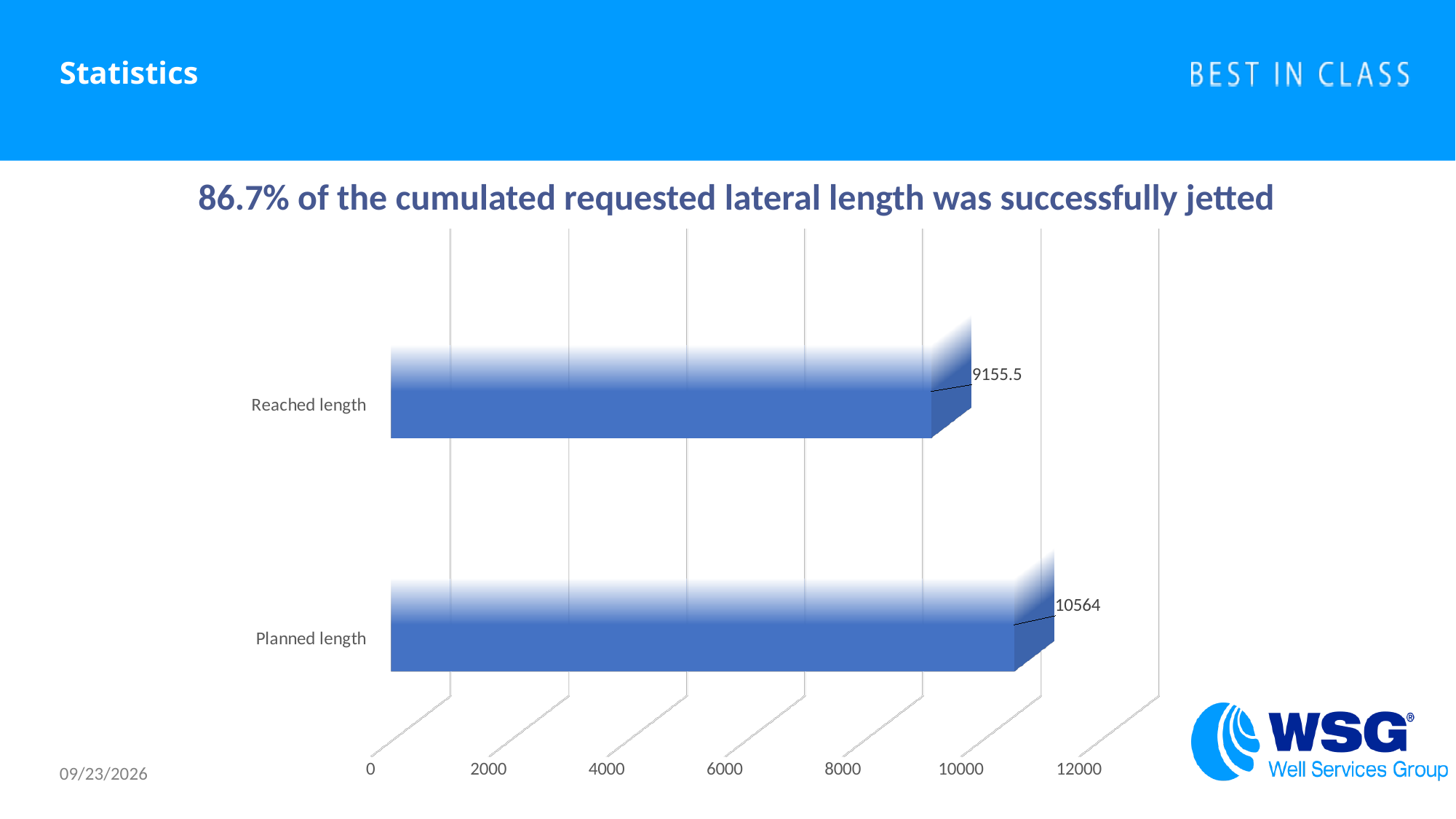
Which category has the highest value? Planned length Is the value for Reached length greater or less than 10000? less What is the value for Reached length? 9155.5 What is the value for Planned length? 10564 What is the title of the chart? 86.7% of the cumulated requested lateral length was successfully jetted What is the difference between Planned length and Reached length? 1408.5 Which category has the lowest value? Reached length What is the highest tick value shown on the value axis? 12000 How many categories are shown in the chart? 2 What kind of chart is shown on the slide? bar chart Is the value for Planned length greater or less than 10000? greater Which is larger, Reached length or Planned length? Planned length